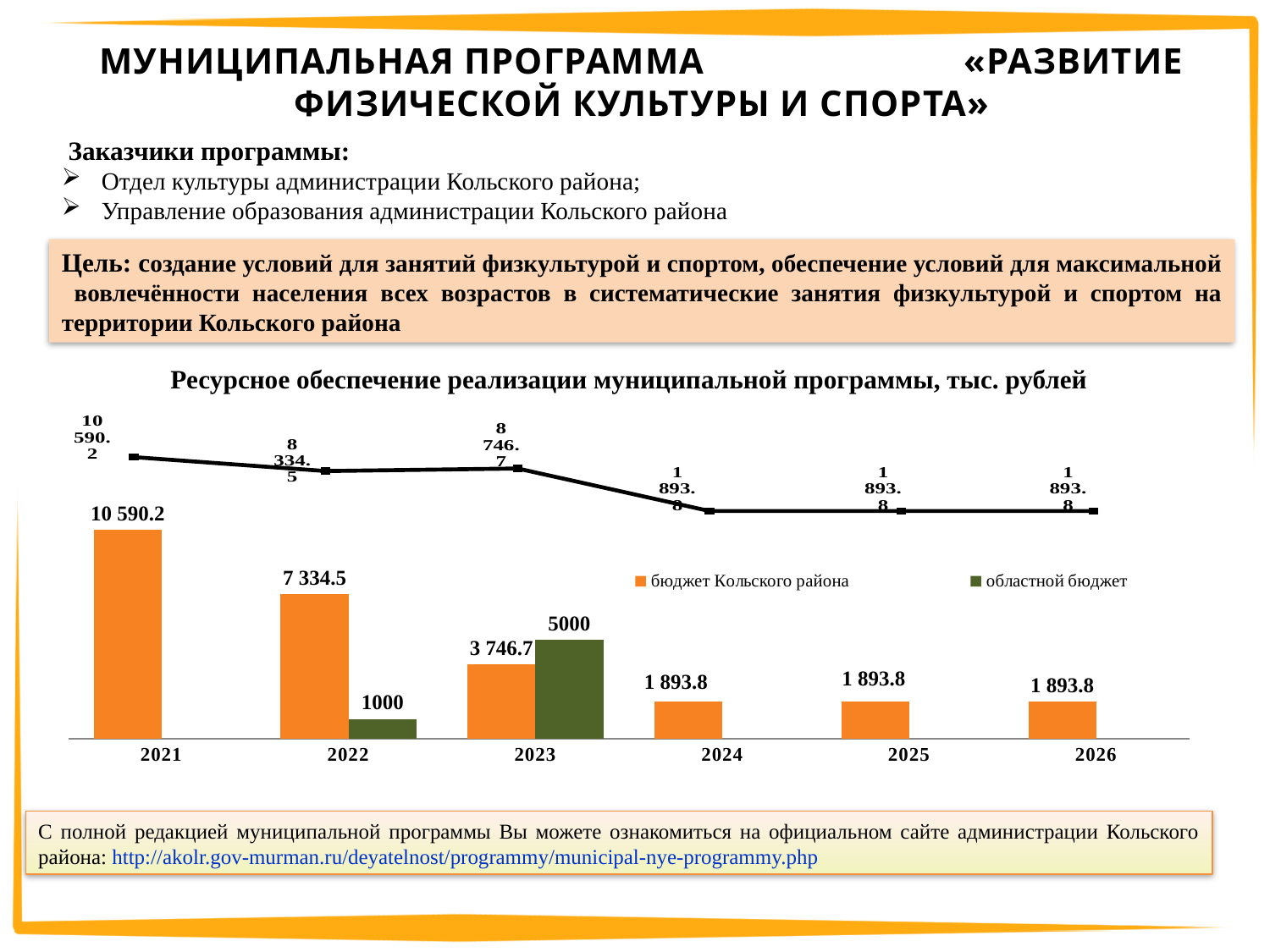
Does бюджет Кольского района rise or fall from 2021 to 2024? fall What is the total of бюджет Кольского района and областной бюджет for 2023? 8 746.7 Which year has the larger value for областной бюджет, 2022 or 2023? 2023 What is the value of бюджет Кольского района for 2021? 10 590.2 In which year is бюджет Кольского района the highest? 2021 What is the difference between бюджет Кольского района in 2021 and in 2022? 3 255.7 How many years are shown on the x axis of the chart? 6 What is the title of the chart? Ресурсное обеспечение реализации муниципальной программы, тыс. рублей What is the value of областной бюджет for 2023? 5000 What is the value of областной бюджет for 2022? 1000 How many series does the chart legend list? 2 What is the value of бюджет Кольского района for 2026? 1 893.8